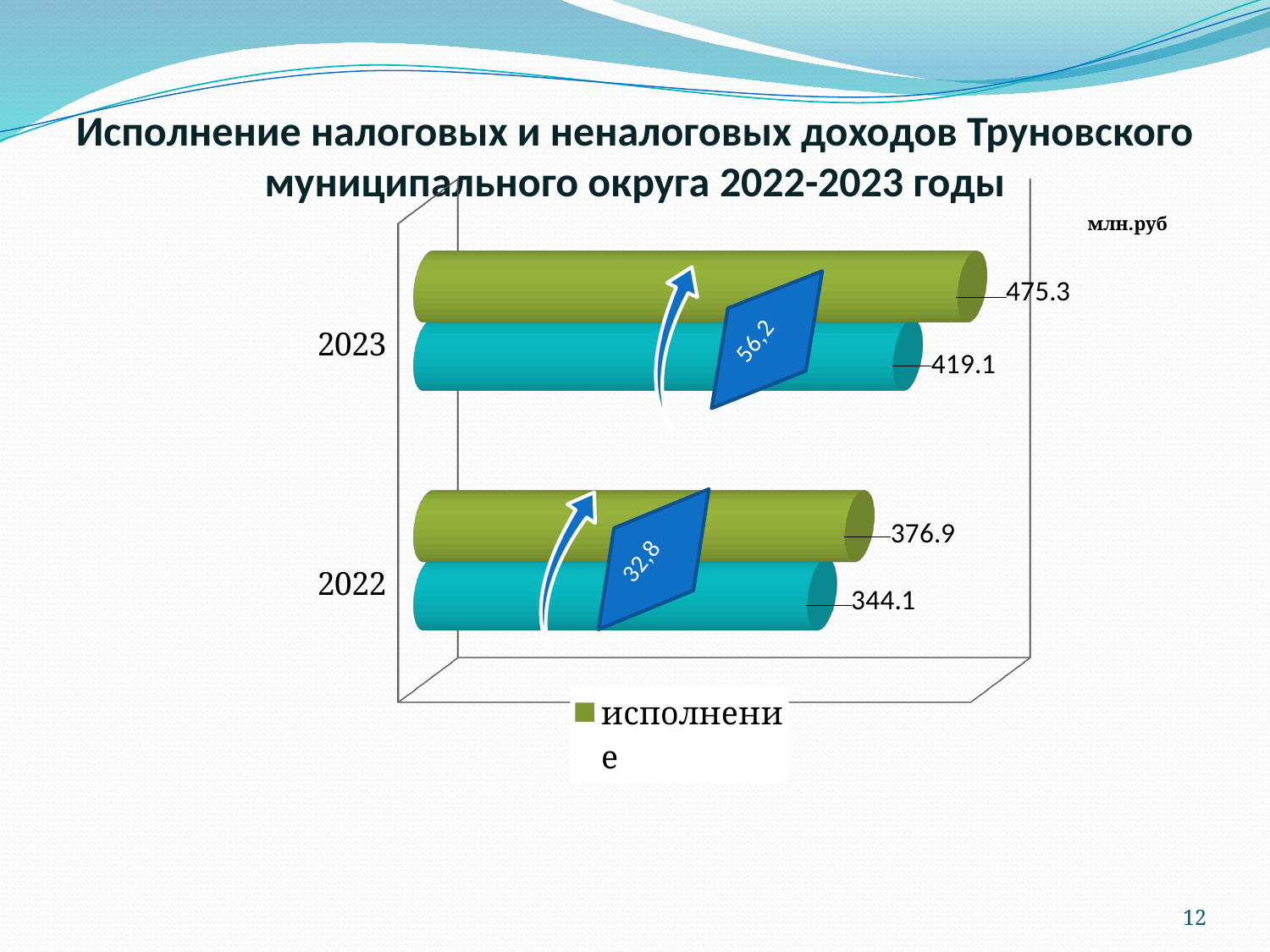
What is the value of the green "исполнение" bar for 2022? 376.9 What is the difference between the "исполнение" values for 2023 and 2022? 98.4 How many year categories are shown on the chart? 2 What unit of measurement is indicated on the chart? млн.руб Which year has the lowest teal bar value? 2022 What is the value of the teal bar for 2023? 419.1 Is the teal bar for 2022 larger or smaller than the green bar for 2022? smaller What is the difference between the green and teal bars for 2023? 56.2 What is the value of the green "исполнение" bar for 2023? 475.3 What is the value of the teal bar for 2022? 344.1 Which year has the higher "исполнение" value? 2023 What type of chart is shown on the slide? bar chart